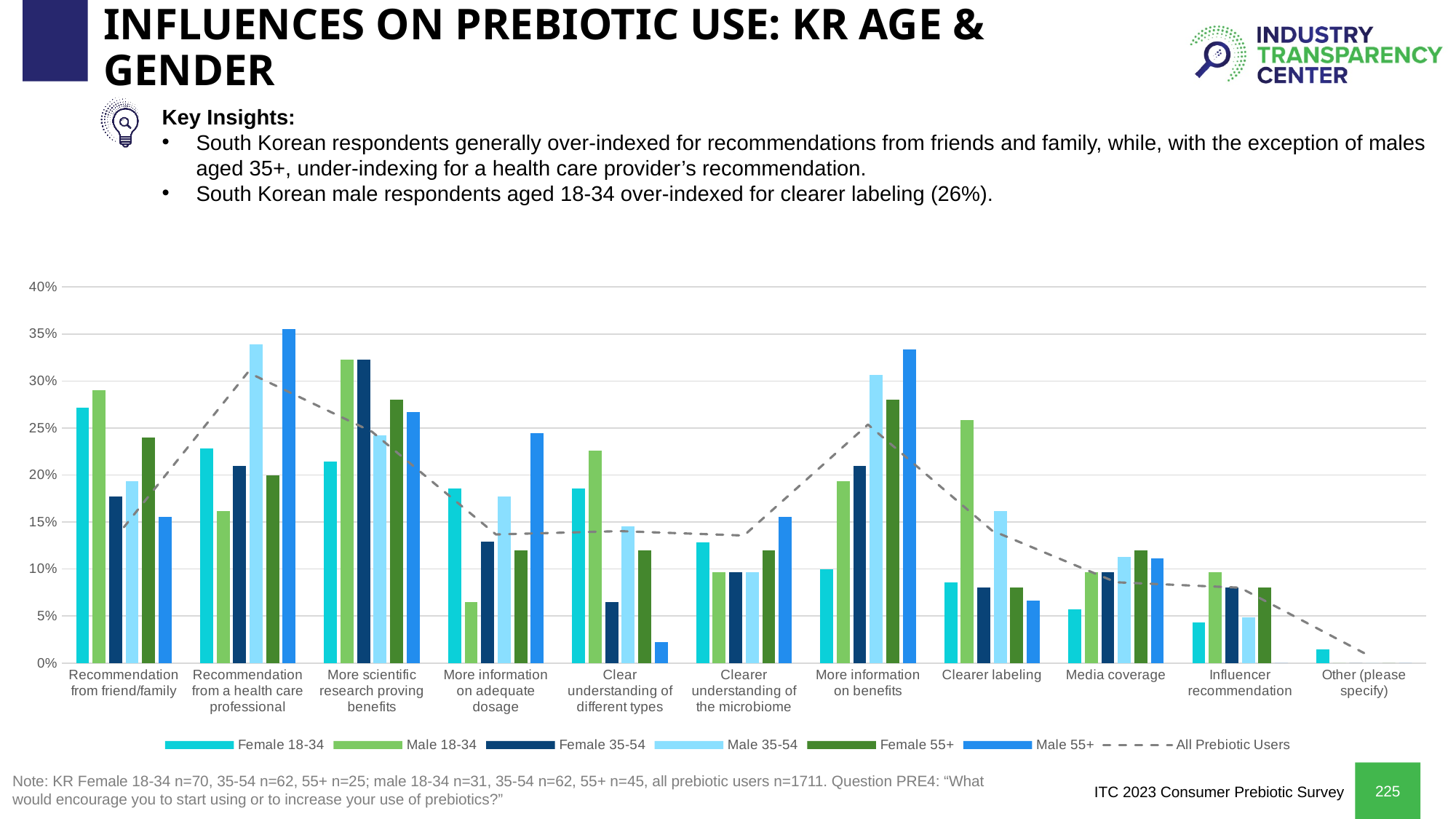
Is the value for Female 18-34 under "Other (please specify)" greater or less than 5%? less Is the value for Male 35-54 under "More information on benefits" greater or less than 25%? greater Under "More information on adequate dosage", which is larger: Female 55+ or Male 55+? Male 55+ Is the value for Male 55+ under "Recommendation from a health care professional" greater or less than 30%? greater What kind of chart is shown on the slide? combination bar and line chart How many categories are shown along the x axis of the chart? 11 Which series has the lowest value under "Clear understanding of different types"? Male 55+ Which series is drawn as a dashed line rather than bars? All Prebiotic Users Which series has the highest value under "Clearer labeling"? Male 18-34 How many series does the chart's legend list? 7